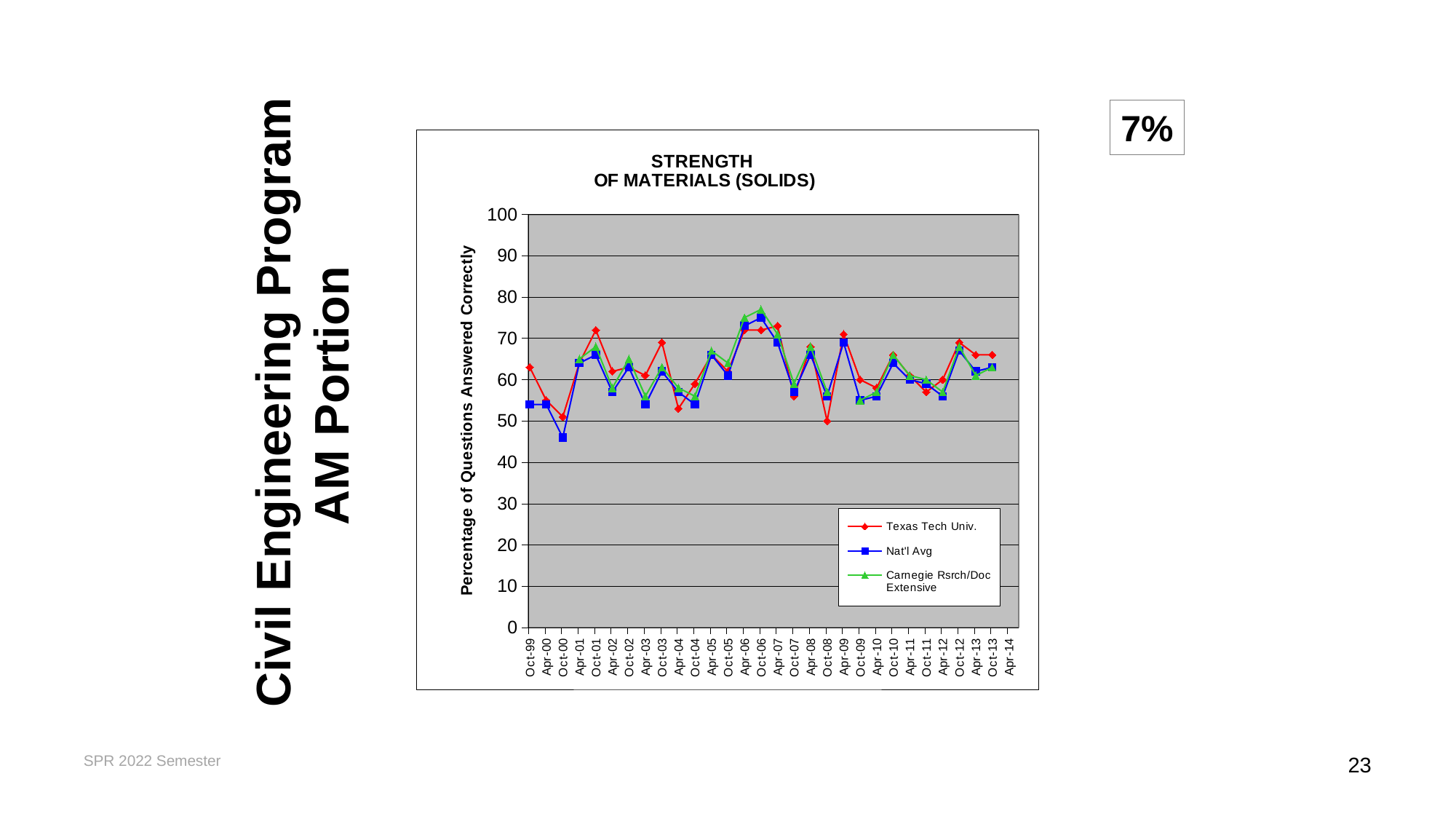
Is the Nat'l Avg value for Oct-00 greater or less than 50? less Is the Nat'l Avg value for Oct-06 greater or less than 70? greater What kind of chart is shown on the slide? Line chart At Oct-00, which is larger: Texas Tech Univ. or Nat'l Avg? Texas Tech Univ. How many series does the legend list? 3 What is the label on the vertical axis of the chart? Percentage of Questions Answered Correctly At which date is the Carnegie Rsrch/Doc Extensive series at its highest? Oct-06 At which date is the Nat'l Avg series at its lowest? Oct-00 Is the Carnegie Rsrch/Doc Extensive value for Oct-06 greater or less than 70? greater At Oct-08, which is larger: Texas Tech Univ. or Nat'l Avg? Nat'l Avg What is the title of the chart? STRENGTH OF MATERIALS (SOLIDS)